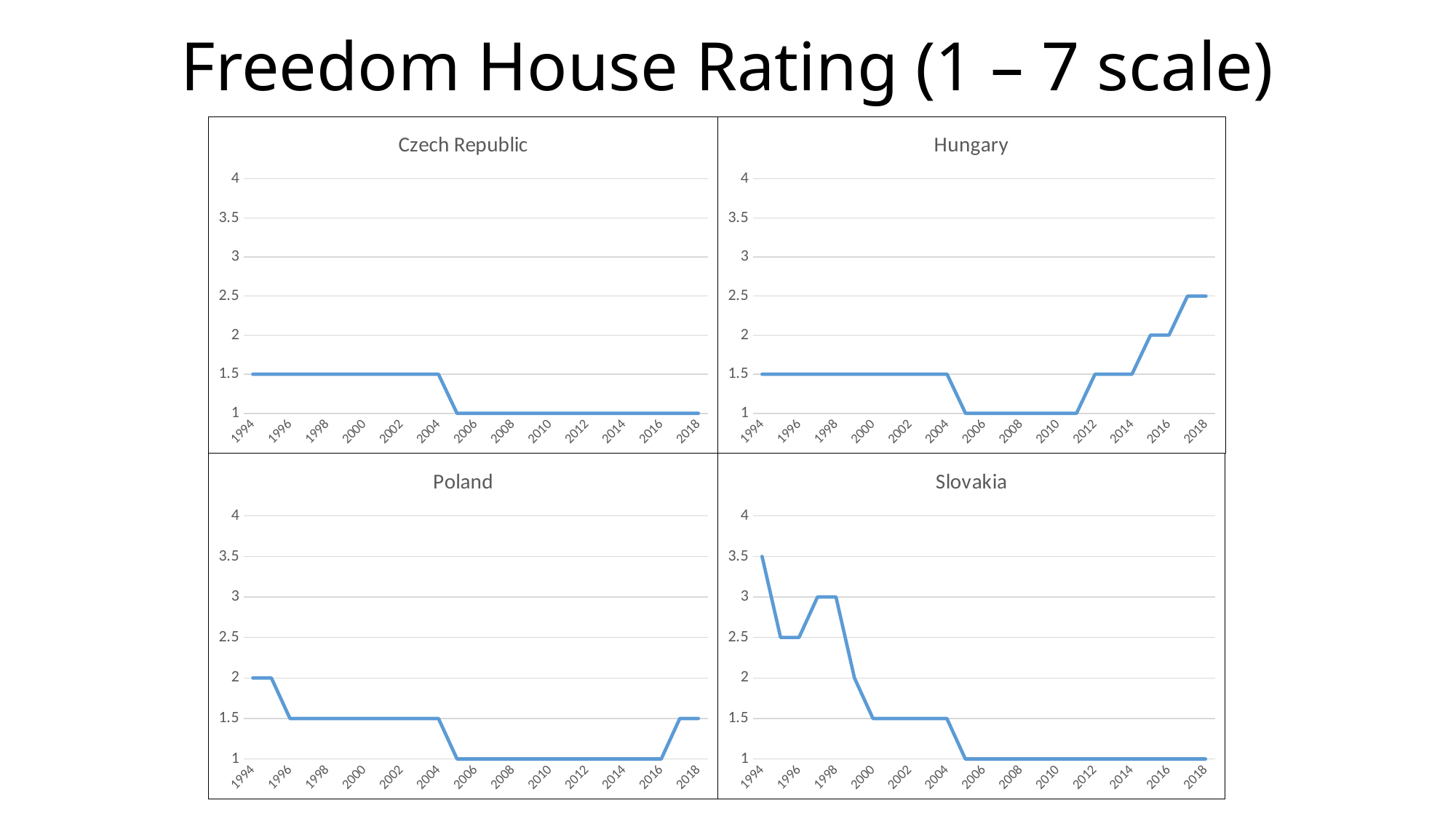
In the Hungary chart, what is the rating in 2018? 2.5 In the Hungary chart, does the rating rise or fall between 2012 and 2018? rise In the Czech Republic chart, what is the rating in 2018? 1 In the Slovakia chart, is the rating in 1994 greater or less than 3? greater Which is higher in 2018: the rating in the Hungary chart or the rating in the Czech Republic chart? Hungary How many country charts are shown on the slide? 4 In the Hungary chart, is the rating in 2018 greater or less than 2? greater In the Poland chart, what is the rating in 1994? 2 In the Slovakia chart, what is the rating in 1994? 3.5 In the Slovakia chart, which year has the highest rating? 1994 What kind of chart is used for the Czech Republic panel? line chart In the Slovakia chart, what is the difference between the rating in 1994 and the rating in 2018? 2.5